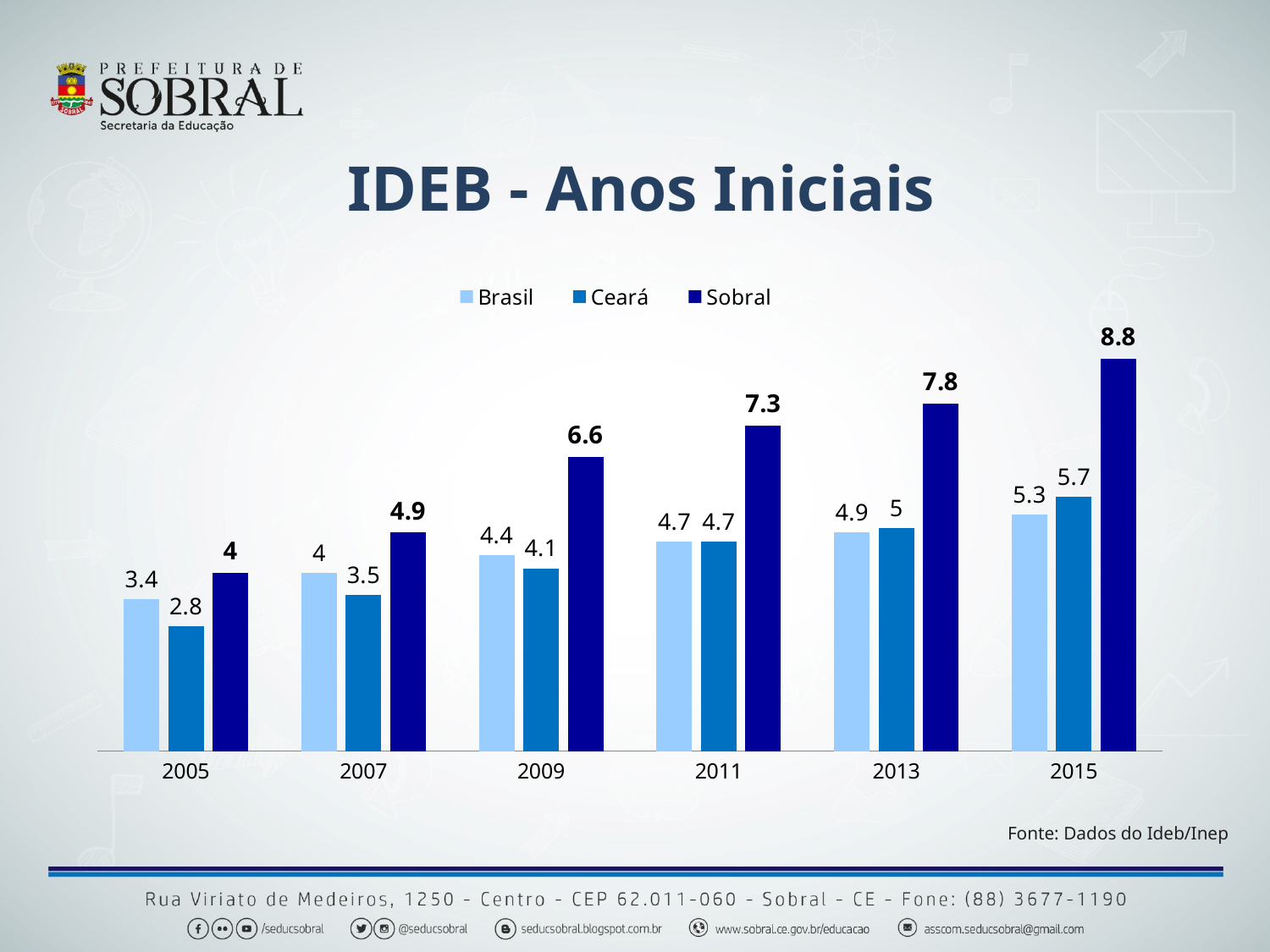
What kind of chart is shown on the slide? bar chart In which year is the Sobral value highest? 2015 Which is larger in 2009, the Brasil value or the Ceará value? Brasil What is the value for Sobral in 2015? 8.8 In which year is the Ceará value lowest? 2005 What is the difference between the Sobral and Brasil values in 2015? 3.5 How many years are shown on the x axis? 6 What is the value for Ceará in 2005? 2.8 Do the Sobral values rise or fall from 2005 to 2015? rise How many series does the legend list? 3 What is the title of the chart? IDEB - Anos Iniciais What is the value for Brasil in 2013? 4.9